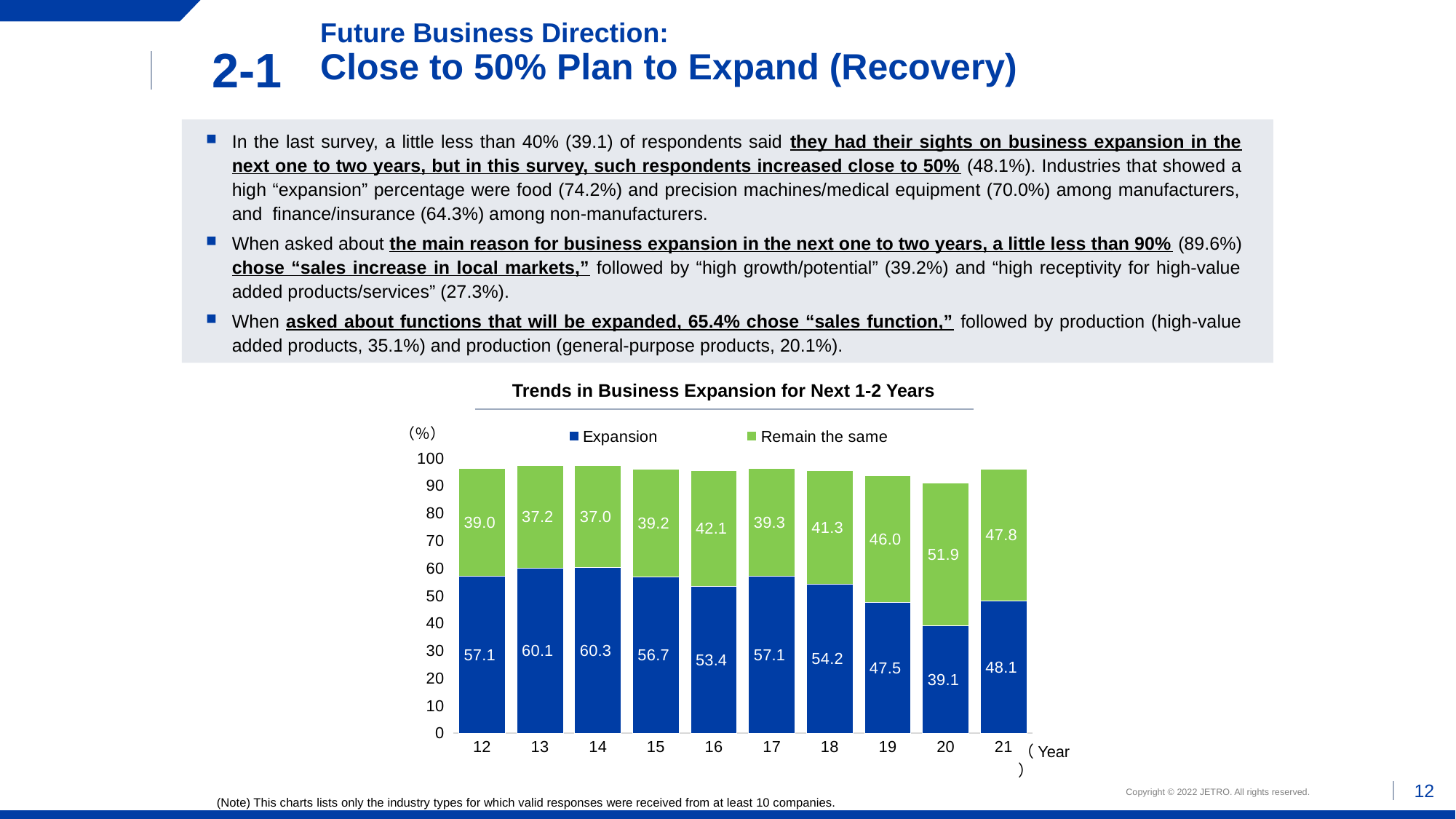
What type of chart is shown on the slide? Stacked bar chart What is the total of the stacked bar for year 20? 91.0 What is the title of the chart? Trends in Business Expansion for Next 1-2 Years What is the Expansion value for year 21? 48.1 How many series does the chart legend list? 2 How many years are shown on the x axis of the chart? 10 Which is larger in year 19: the Expansion value or the Remain the same value? Expansion Which year has the lowest Expansion value? 20 Which year has the highest Expansion value? 14 What is the difference between the Expansion values for year 21 and year 20? 9.0 Which year has the highest Remain the same value? 20 What is the Remain the same value for year 16? 42.1